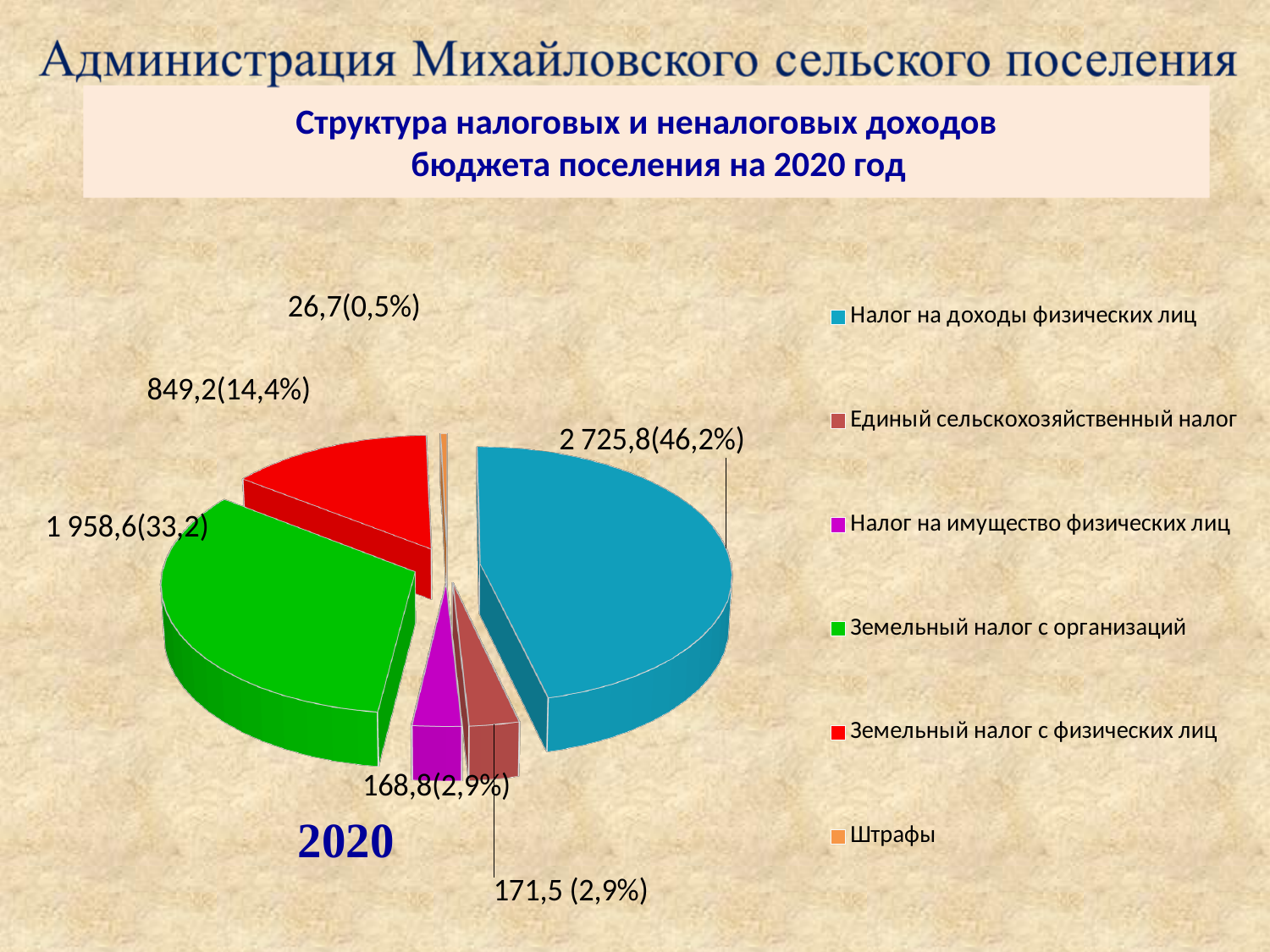
Какое значение указано для категории «Единый сельскохозяйственный налог»? 171,5 (2,9%) Какая категория имеет наименьшую долю в диаграмме? Штрафы Какое значение указано для категории «Налог на доходы физических лиц»? 2 725,8(46,2%) Какой тип диаграммы показан на слайде? Круговая диаграмма Какая категория имеет наибольшую долю в диаграмме? Налог на доходы физических лиц Какую долю составляет «Налог на имущество физических лиц»? 2,9% Сколько категорий перечислено в легенде диаграммы? 6 Каким цветом на диаграмме обозначен «Земельный налог с физических лиц»? Красным Какое значение указано для категории «Штрафы»? 26,7(0,5%) Какое значение указано для категории «Земельный налог с физических лиц»? 849,2(14,4%) Какое значение указано для категории «Земельный налог с организаций»? 1 958,6(33,2) Что больше: «Земельный налог с организаций» или «Земельный налог с физических лиц»? Земельный налог с организаций